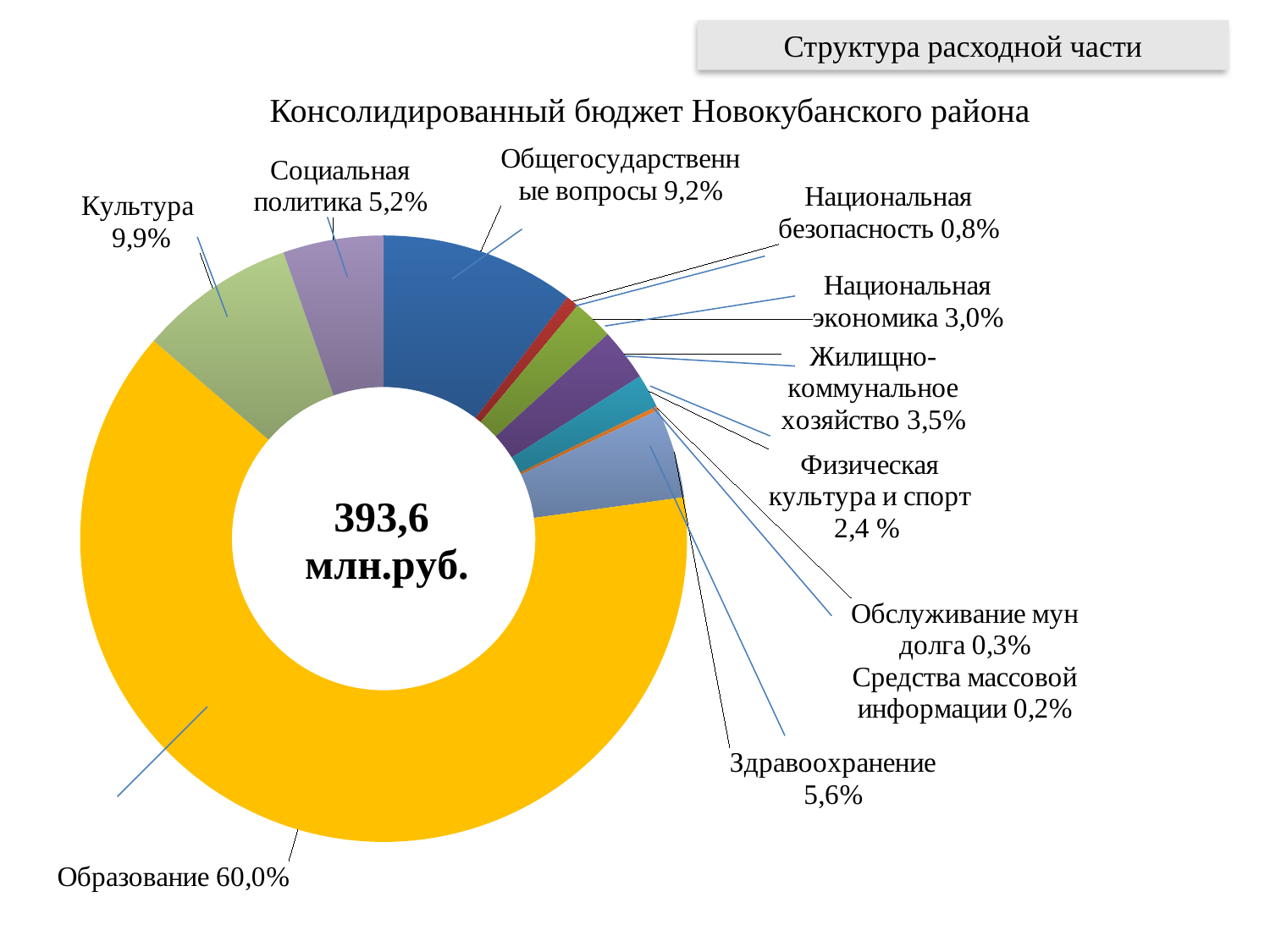
Which category has the smallest share of the consolidated budget? Средства массовой информации What share of the consolidated budget goes to Общегосударственные вопросы? 9,2% What total amount is shown in the centre of the chart? 393,6 млн.руб. Which has a larger share, Национальная экономика or Физическая культура и спорт? Национальная экономика How many categories are shown in the chart? 11 Which category has the largest share of the consolidated budget? Образование What share of the consolidated budget goes to Здравоохранение? 5,6% What share of the consolidated budget goes to Образование? 60,0% What is the title of the chart? Консолидированный бюджет Новокубанского района What share of the consolidated budget goes to Жилищно-коммунальное хозяйство? 3,5% What is the difference in percentage points between Культура and Социальная политика? 4,7 What kind of chart is shown on the slide? Doughnut chart